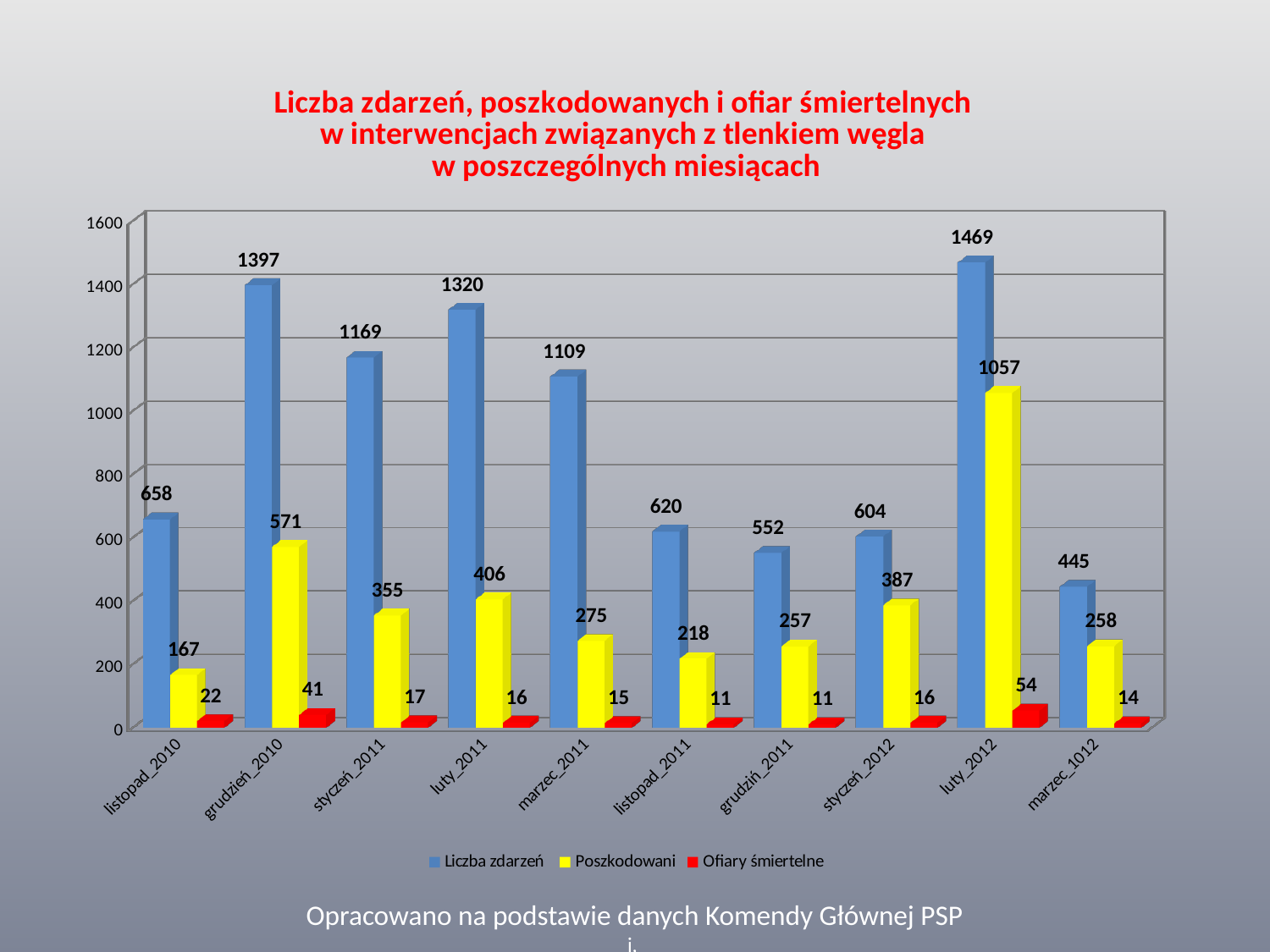
Which colour represents the Poszkodowani series? yellow What kind of chart is shown on the slide? bar chart How many months are shown on the x axis? 10 What is the value of Liczba zdarzeń for luty_2012? 1469 How many series does the legend list? 3 What is the value of Ofiary śmiertelne for listopad_2010? 22 What is the difference between Liczba zdarzeń for grudzień_2010 and for styczeń_2011? 228 What is the highest value of Ofiary śmiertelne shown, and in which month? 54, luty_2012 Which is larger: Poszkodowani for luty_2011 or for styczeń_2012? luty_2011 What is the value of Poszkodowani for grudzień_2010? 571 Which month has the highest value of Liczba zdarzeń? luty_2012 Which month has the lowest value of Poszkodowani? listopad_2010